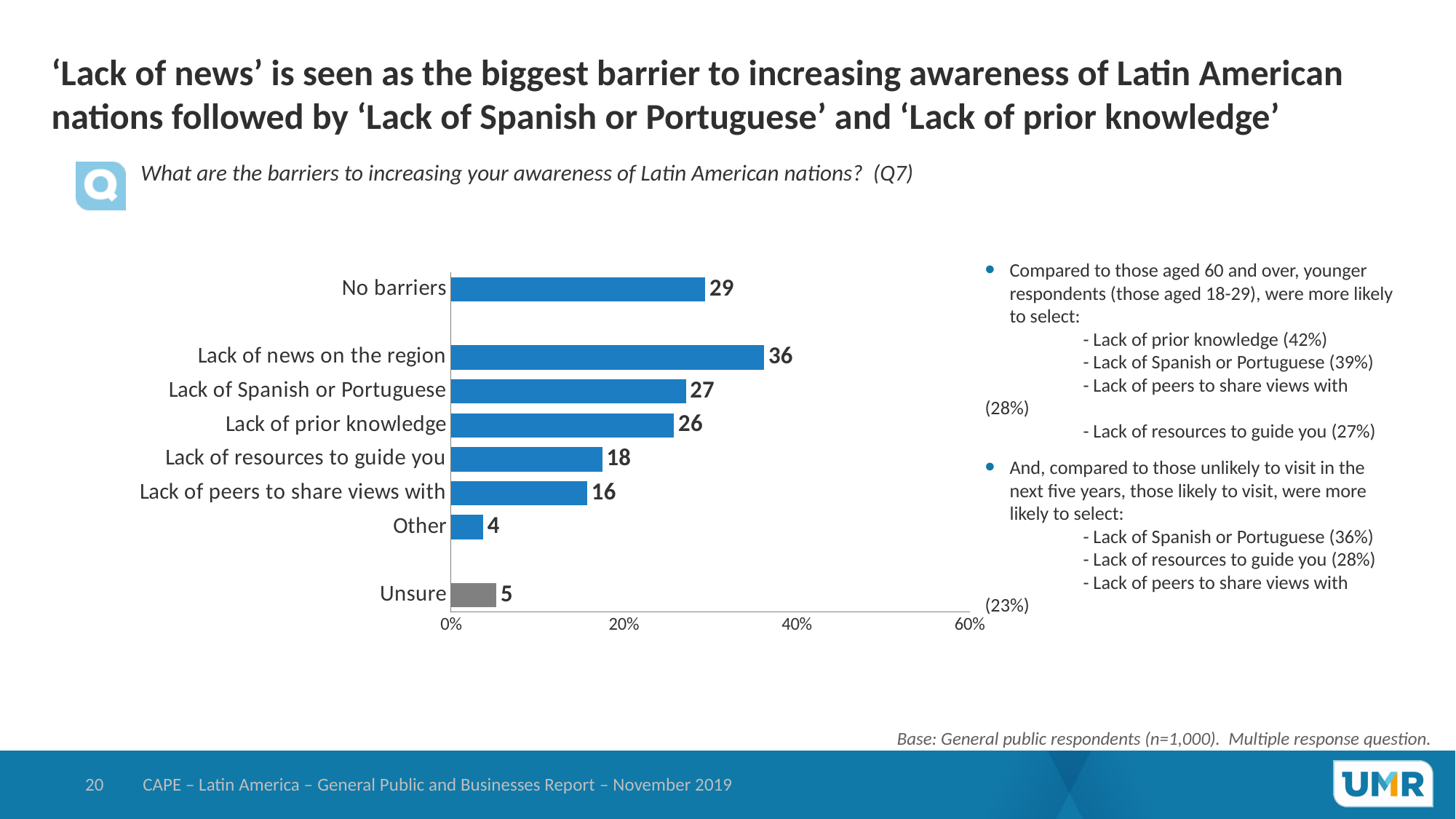
Is the value for 'Lack of news on the region' greater or less than 40%? less What kind of chart is shown on the slide? Bar chart Which category has the lowest value? Other What is the value for 'Unsure'? 5 Which bar is shown in grey rather than blue? Unsure What is the difference between 'No barriers' and 'Lack of resources to guide you'? 11 How many categories are shown in the chart? 8 What is the value for 'Lack of news on the region'? 36 What is the value for 'Lack of peers to share views with'? 16 Which category has the highest value? Lack of news on the region What is the difference between 'Lack of news on the region' and 'Lack of Spanish or Portuguese'? 9 Which is larger, 'Lack of prior knowledge' or 'Lack of resources to guide you'? Lack of prior knowledge